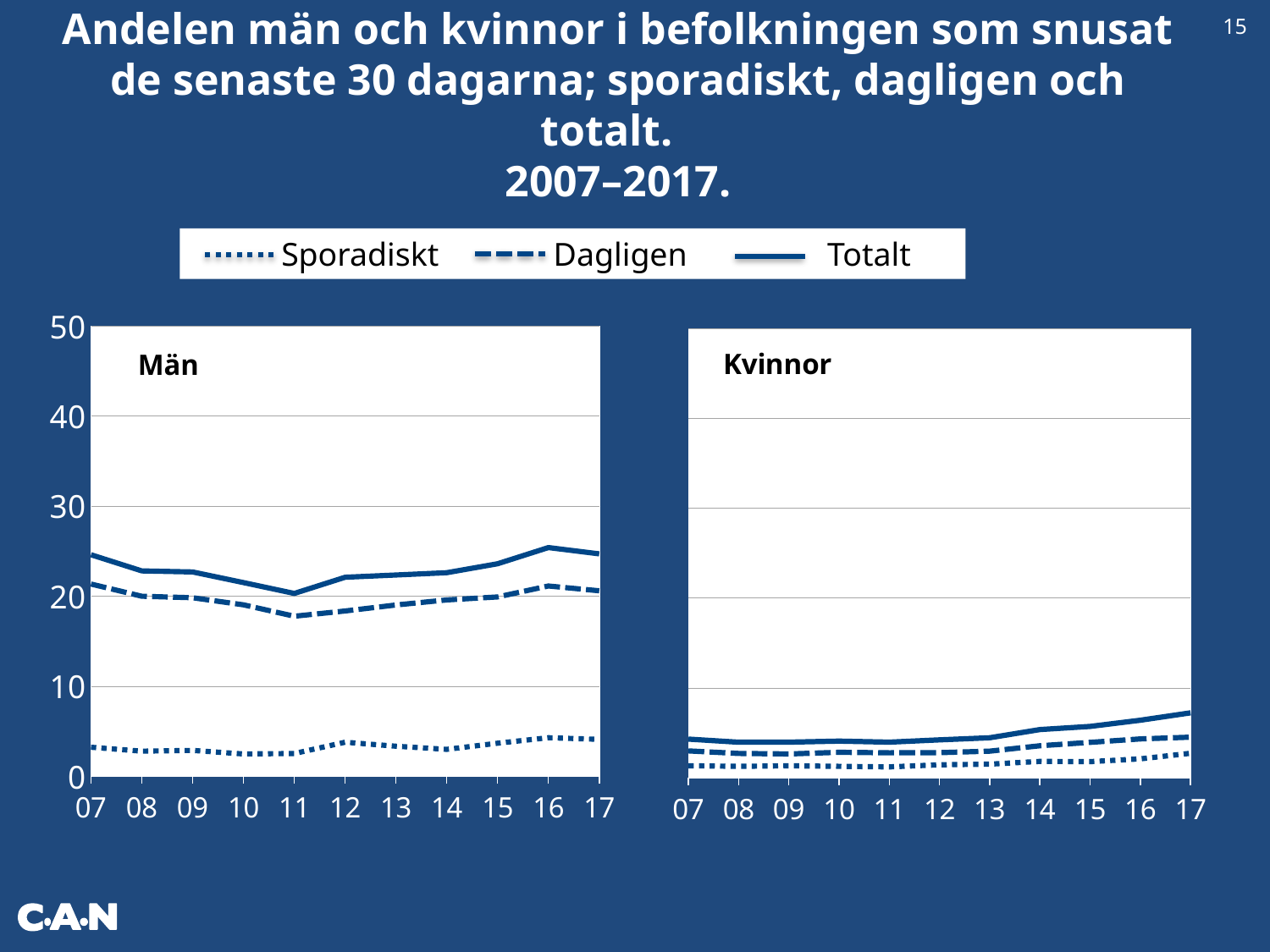
In the Kvinnor chart, does the Totalt line rise or fall from 13 to 17? rise In the Män chart, which year has the lowest Totalt value? 11 In the Män chart, is the Totalt value for 07 greater or less than 20? greater What kind of chart is the Män chart? line chart How many years are plotted on the x axis of the Kvinnor chart? 11 In the Män chart, is the Sporadiskt value for 12 greater or less than 10? less How many series does the legend list? 3 In the Kvinnor chart, which year has the highest Totalt value? 17 In the Kvinnor chart, is the Totalt value for 17 greater or less than 10? less In the Män chart, does the Totalt line rise or fall from 07 to 11? fall Which line style does the legend use for Sporadiskt? dotted Which chart shows a higher Totalt value for 17, Män or Kvinnor? Män